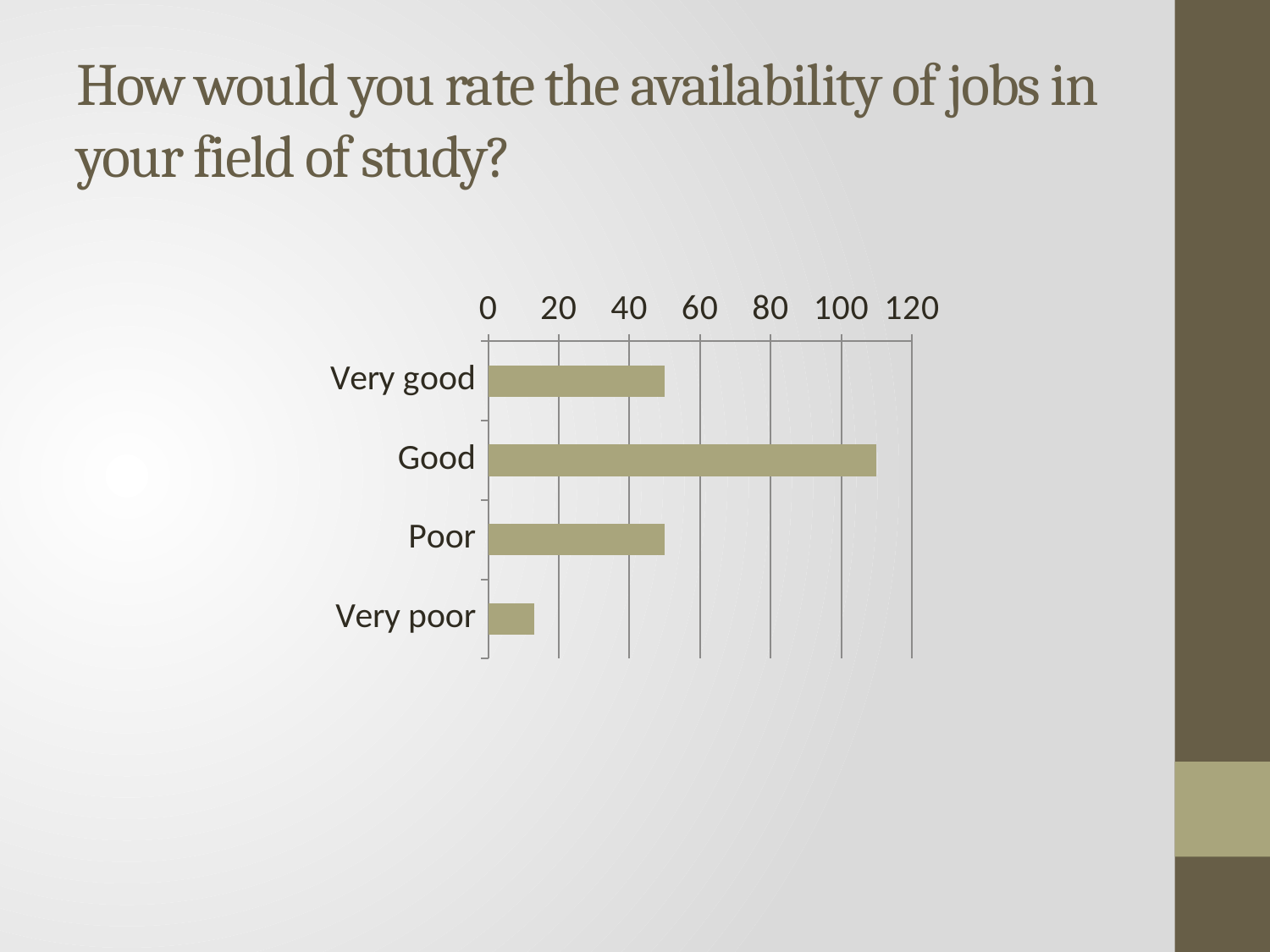
Which category has the lowest value? Very poor Is the value for Very good greater or less than 40? greater Which category has the highest value? Good Which is larger, the value for Good or the value for Poor? Good Which is larger, the value for Very good or the value for Very poor? Very good How many categories are shown on the chart? 4 What kind of chart is shown on the slide? bar chart Is the value for Very good greater or less than 60? less Is the value for Poor greater or less than 60? less What is the highest value shown on the chart's value axis? 120